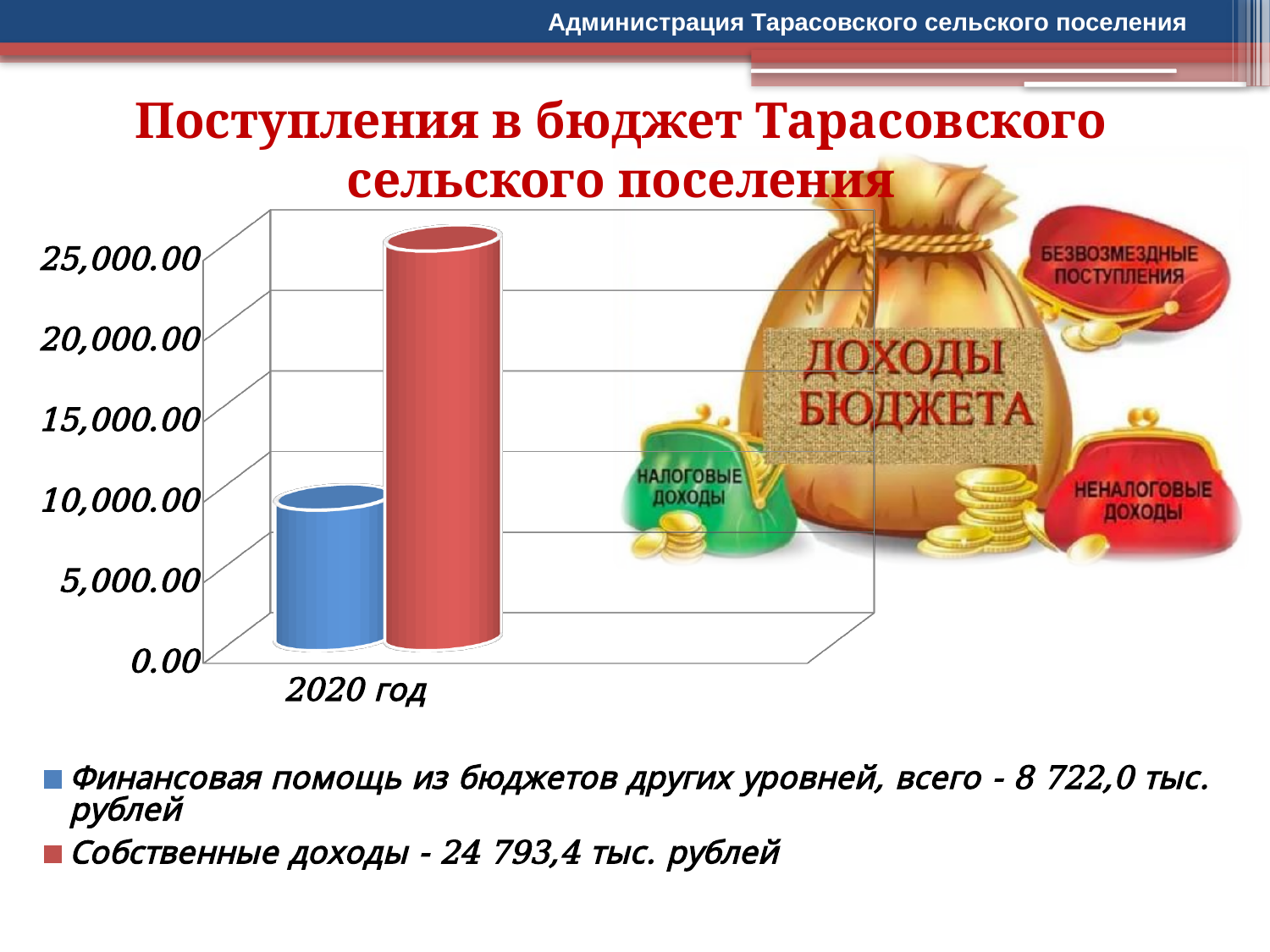
What is the category label on the x axis? 2020 год What is the value of Собственные доходы according to the legend? 24 793,4 тыс. рублей Which series has the lower value in 2020? Финансовая помощь из бюджетов других уровней, всего Which series has the higher value in 2020? Собственные доходы Which colour represents Собственные доходы in the chart? red Is the value for Финансовая помощь из бюджетов других уровней greater or less than 10,000.00? less What is the difference between Собственные доходы and Финансовая помощь из бюджетов других уровней, in тыс. рублей? 16 071,4 Is the value for Собственные доходы greater or less than 20,000.00? greater What is the value of Финансовая помощь из бюджетов других уровней, всего according to the legend? 8 722,0 тыс. рублей How many series does the legend list? 2 How many categories are shown on the x axis of the chart? 1 What type of chart is shown on the slide? bar chart